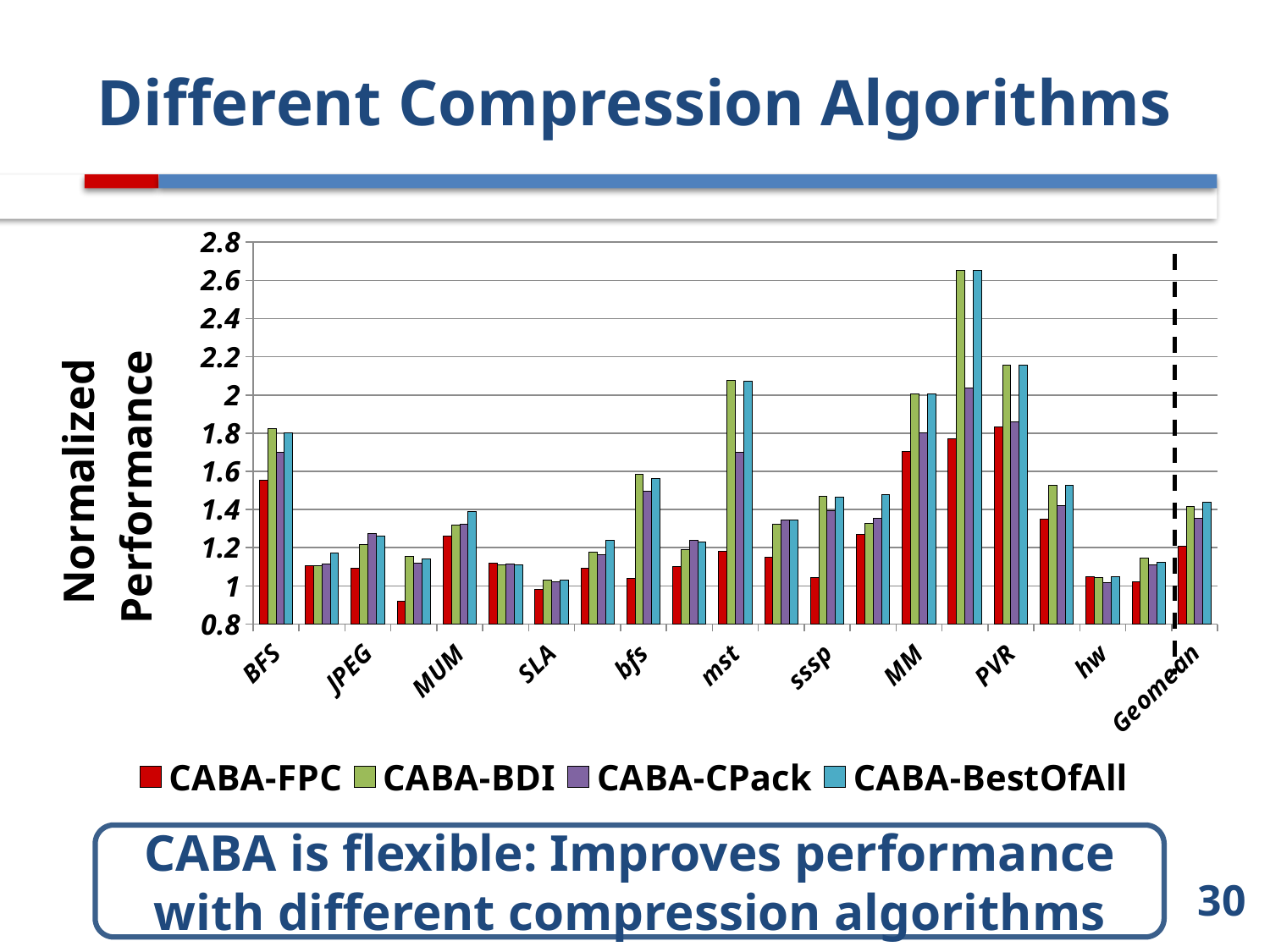
Is the CABA-BDI value for PVR greater or less than 2.4? less How many series does the legend list? 4 Is the CABA-FPC value for MUM greater or less than 1? greater What is the label of the y axis? Normalized Performance What kind of chart is shown on the slide? bar chart Is the CABA-BDI value for Geomean greater or less than 1.2? greater For PVR, which is larger: CABA-BDI or CABA-CPack? CABA-BDI For MUM, which is larger: CABA-BestOfAll or CABA-FPC? CABA-BestOfAll